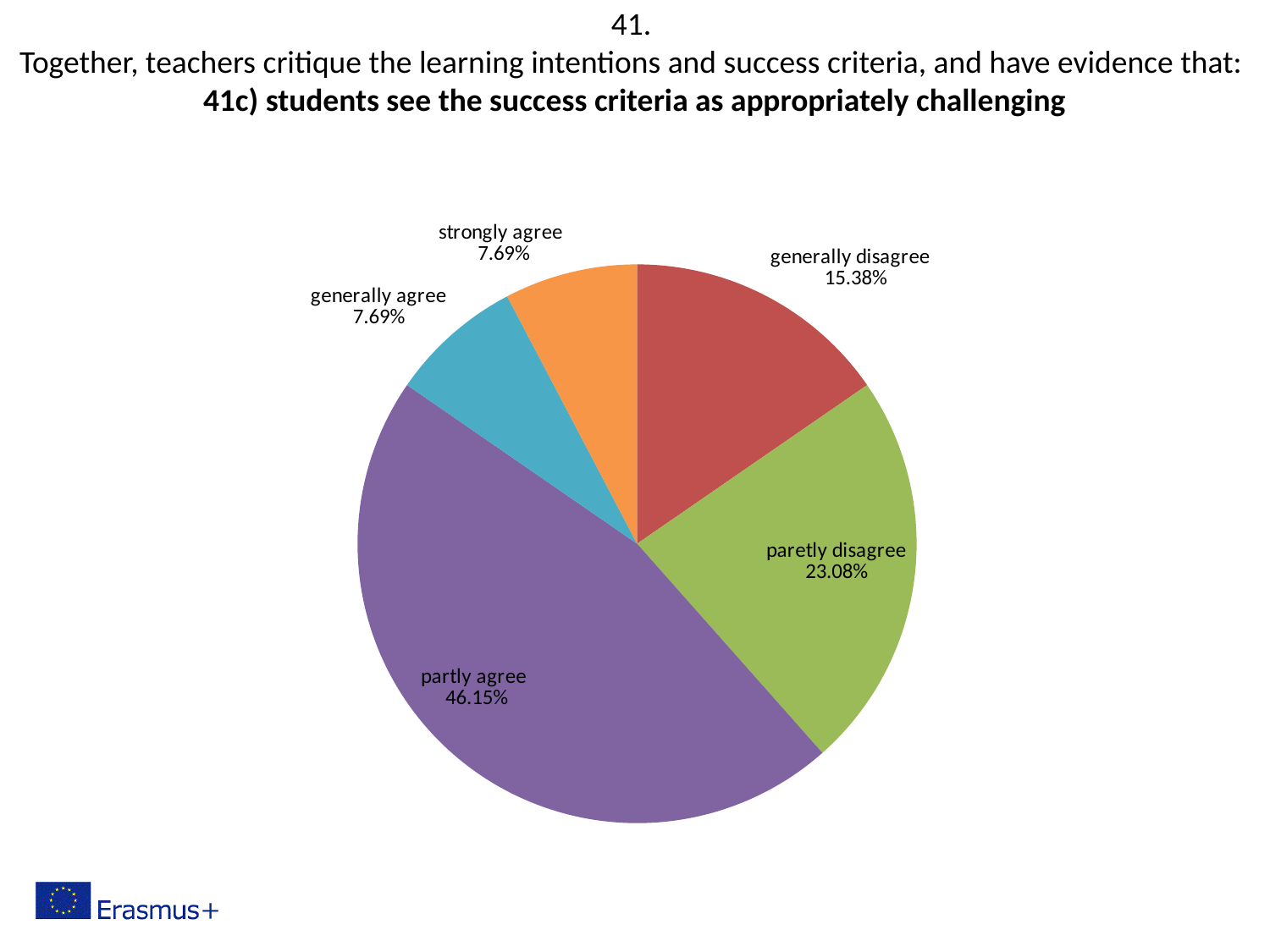
What percentage of respondents chose 'partly agree'? 46.15% What percentage of respondents chose 'generally disagree'? 15.38% What is the difference in percentage points between 'generally disagree' and 'generally agree'? 7.69 What kind of chart is shown on the slide? pie chart Which two categories have the same share of the pie? strongly agree and generally agree Which category has the largest share of the pie? partly agree What colour is the 'partly agree' slice? purple Which is larger, the share for 'generally disagree' or the share for 'paretly disagree'? paretly disagree How many slices does the pie chart have? 5 What percentage of respondents chose 'paretly disagree'? 23.08% What is the difference in percentage points between 'partly agree' and 'paretly disagree'? 23.07 What percentage of respondents chose 'strongly agree'? 7.69%